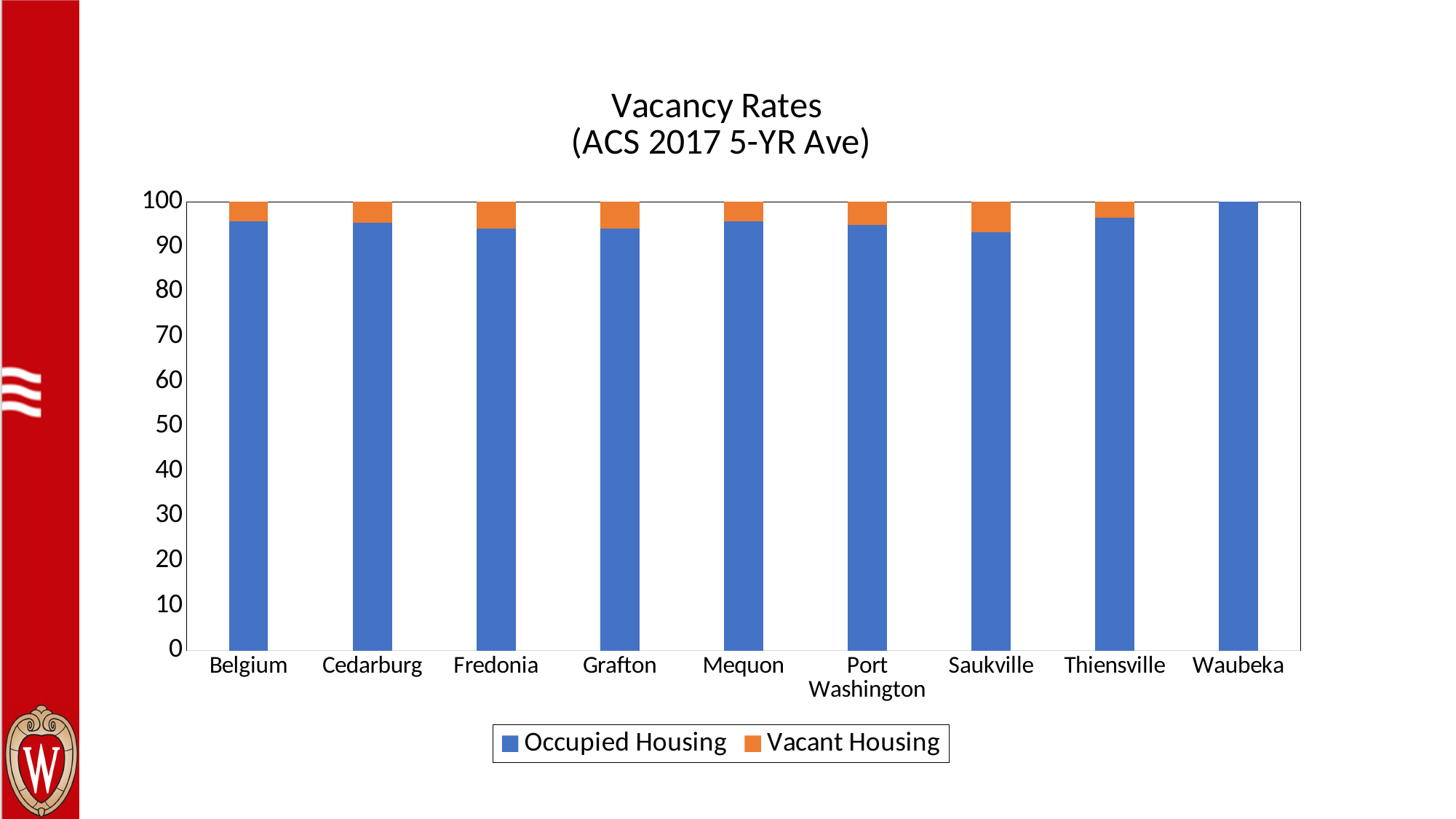
Which community has the highest Occupied Housing value? Waubeka How many communities are shown on the x axis of the chart? 9 What is the title of the chart? Vacancy Rates (ACS 2017 5-YR Ave) Is the Vacant Housing value for Belgium greater or less than 10? less Is the Occupied Housing value for Saukville greater or less than 90? greater What is the Occupied Housing value for Waubeka? 100 Is the Occupied Housing value for Grafton greater or less than 80? greater How many series does the legend list? 2 Which has the larger Occupied Housing value, Waubeka or Belgium? Waubeka What kind of chart is shown on the slide? Stacked bar chart Which has the larger Occupied Housing value, Thiensville or Saukville? Thiensville What are the two series listed in the legend? Occupied Housing and Vacant Housing